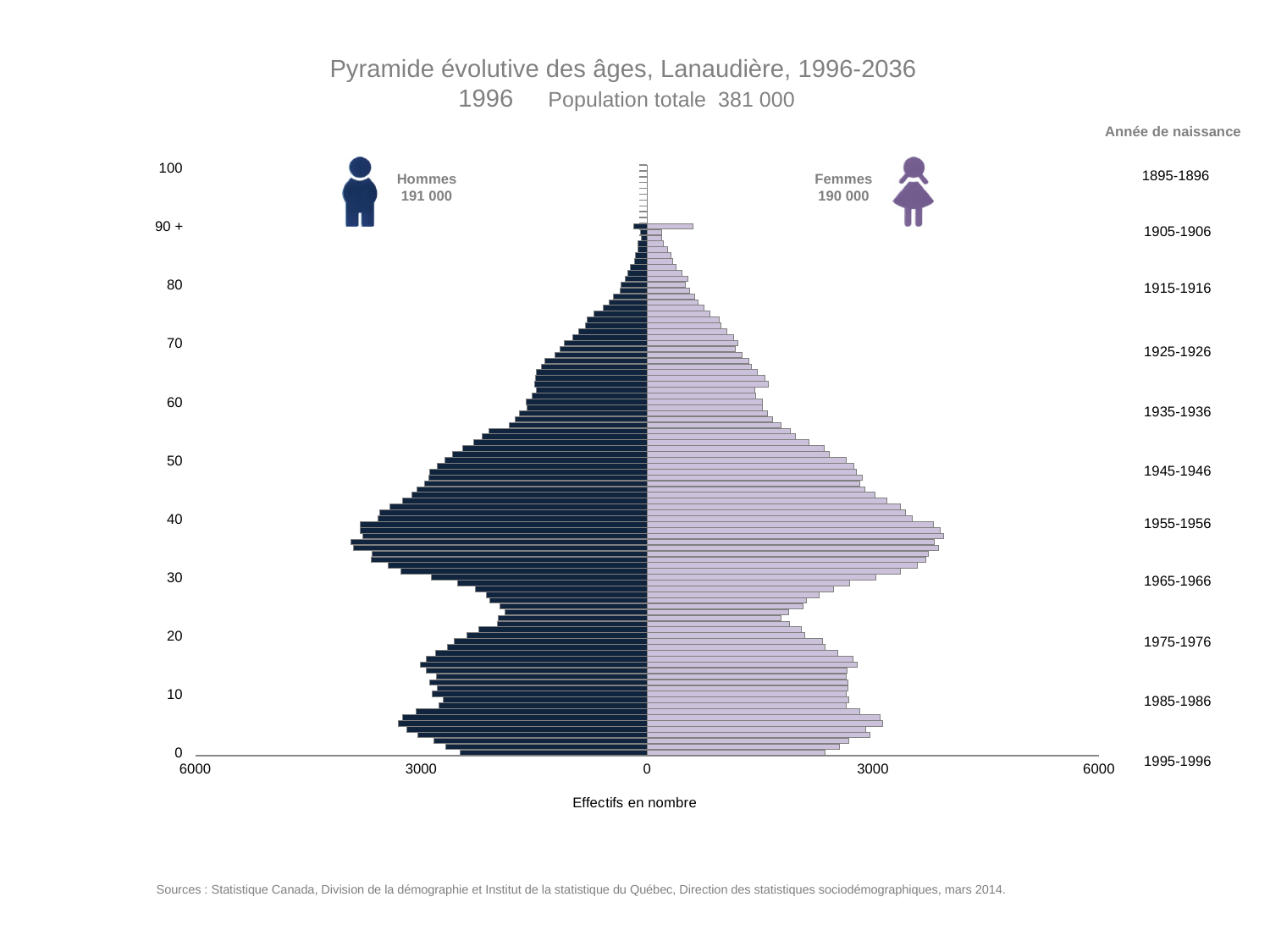
What is the sum of the Hommes and Femmes totals? 381 000 Is the number of men aged about 36 greater or less than 3000? greater What is the label of the horizontal axis? Effectifs en nombre How many series (population groups) does the chart show? 2 What is the number of Hommes (men) shown on the chart? 191 000 From age 40 upward to 90+, do the bar lengths generally increase or decrease? decrease What is the total population shown for 1996? 381 000 Which group is larger in total, Hommes or Femmes? Hommes What is the difference between the total number of Hommes and Femmes? 1 000 What is the number of Femmes (women) shown on the chart? 190 000 What kind of chart is shown on the slide? Bar chart (population pyramid) Is the number of women aged about 80 greater or less than 3000? less